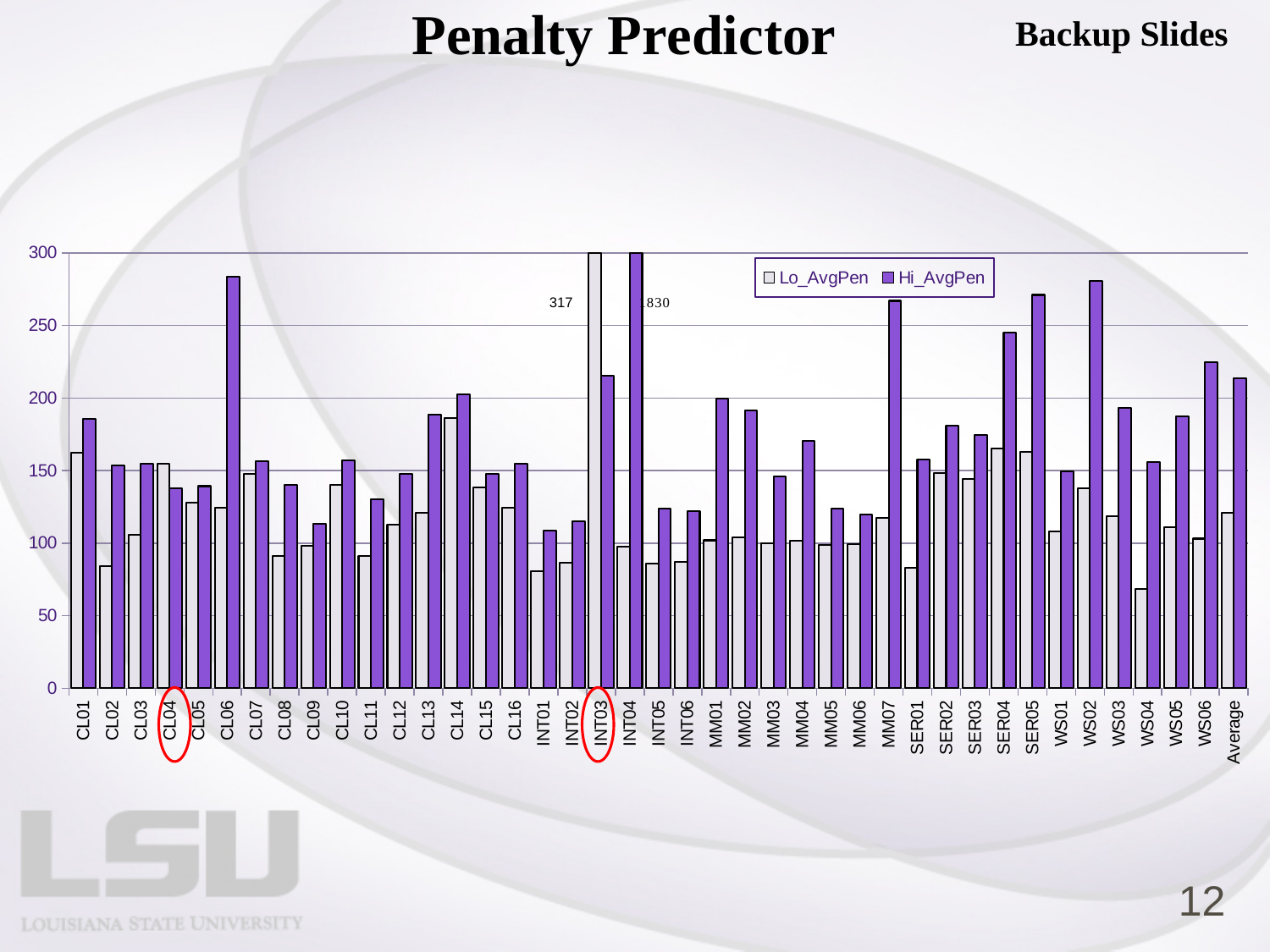
How many categories are shown along the x axis? 41 What is the title of the slide containing the chart? Penalty Predictor What is the Lo_AvgPen value for INT03? 317 Which category has the lowest Lo_AvgPen value? WS04 How many series does the legend list? 2 Which category has the highest Hi_AvgPen value? INT04 What are the two series named in the legend? Lo_AvgPen and Hi_AvgPen Which category has the highest Lo_AvgPen value? INT03 What kind of chart is shown on the slide? bar chart Is the Hi_AvgPen value for CL06 greater or less than 250? greater